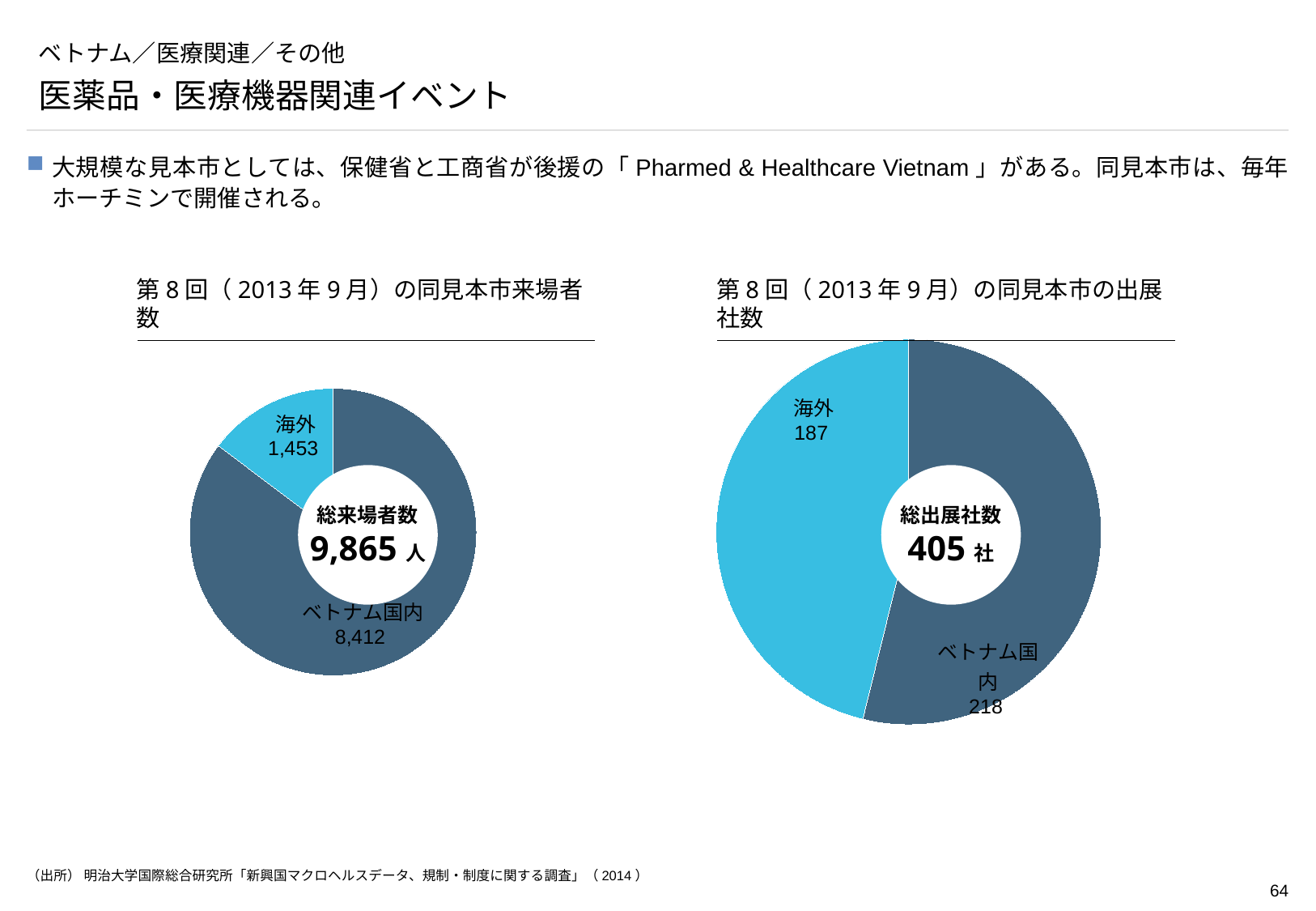
How many categories does the right chart show? 2 In the right chart (exhibitor numbers), what is the value for ベトナム国内 (domestic Vietnam)? 218 In the right chart, which category is the smallest? 海外 In the left chart, which category is the largest? ベトナム国内 In the right chart, what is the total number of exhibitors shown in the centre? 405 社 In the left chart (visitor numbers), what is the value for 海外 (overseas)? 1,453 In the left chart (visitor numbers), what is the value for ベトナム国内 (domestic Vietnam)? 8,412 In the left chart, what is the total number of visitors shown in the centre? 9,865 人 In the right chart, what is the difference between ベトナム国内 and 海外 exhibitors? 31 In the left chart, what is the difference between ベトナム国内 and 海外 visitors? 6,959 What type of chart is used on the left side of the slide? Pie (donut) chart In the right chart (exhibitor numbers), what is the value for 海外 (overseas)? 187